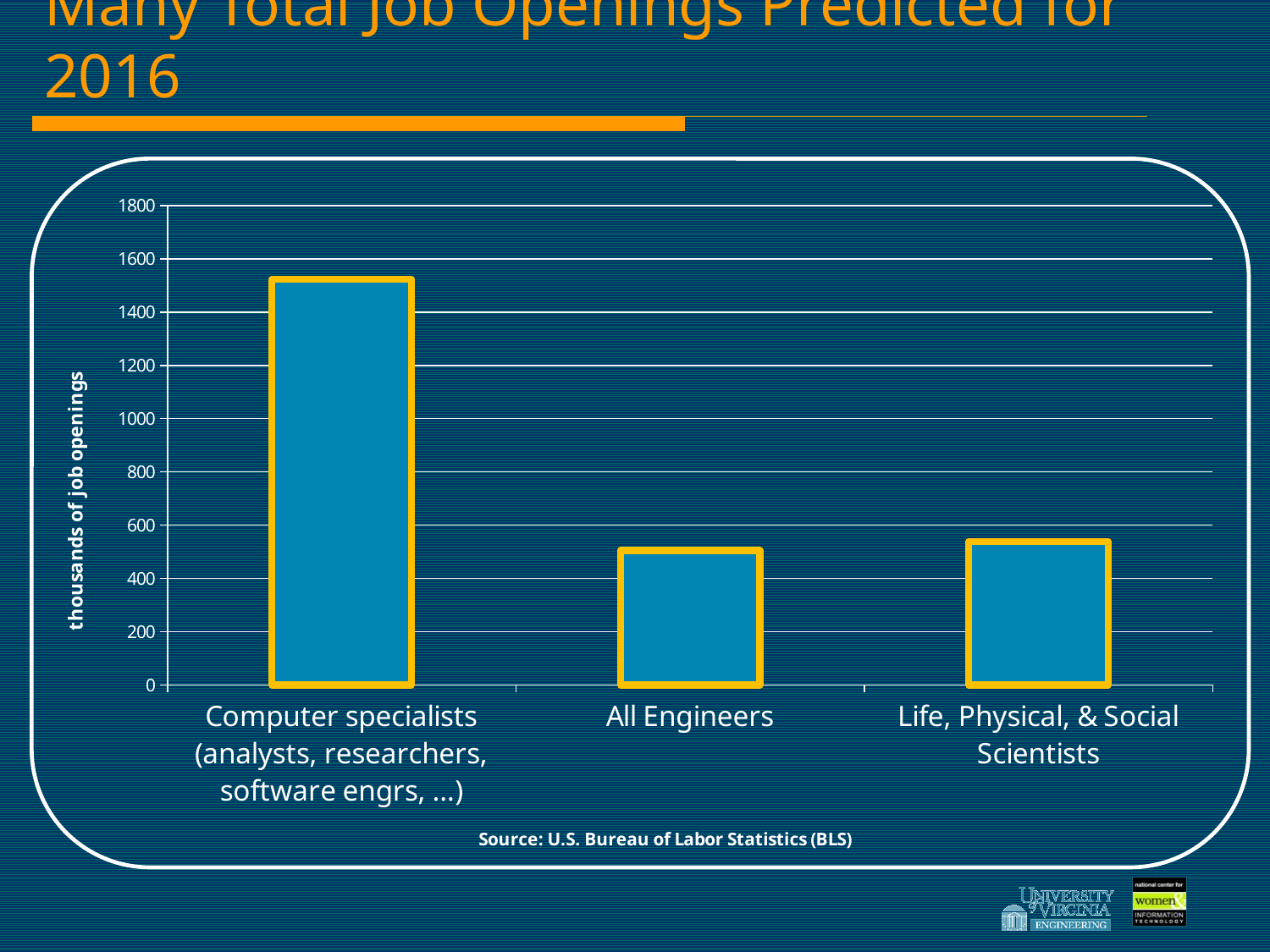
Is the value for Life, Physical, & Social Scientists greater or less than 400? greater What is the label on the vertical axis of the chart? thousands of job openings Is the value for Computer specialists greater or less than 1600? less Is the value for All Engineers greater or less than 600? less Which is larger, the value for All Engineers or the value for Life, Physical, & Social Scientists? Life, Physical, & Social Scientists How many categories are shown on the x axis of the chart? 3 What source is cited below the chart? U.S. Bureau of Labor Statistics (BLS) What kind of chart is shown on the slide? bar chart Which category has the highest predicted number of job openings? Computer specialists (analysts, researchers, software engrs, ...) Which category has the lowest predicted number of job openings? All Engineers